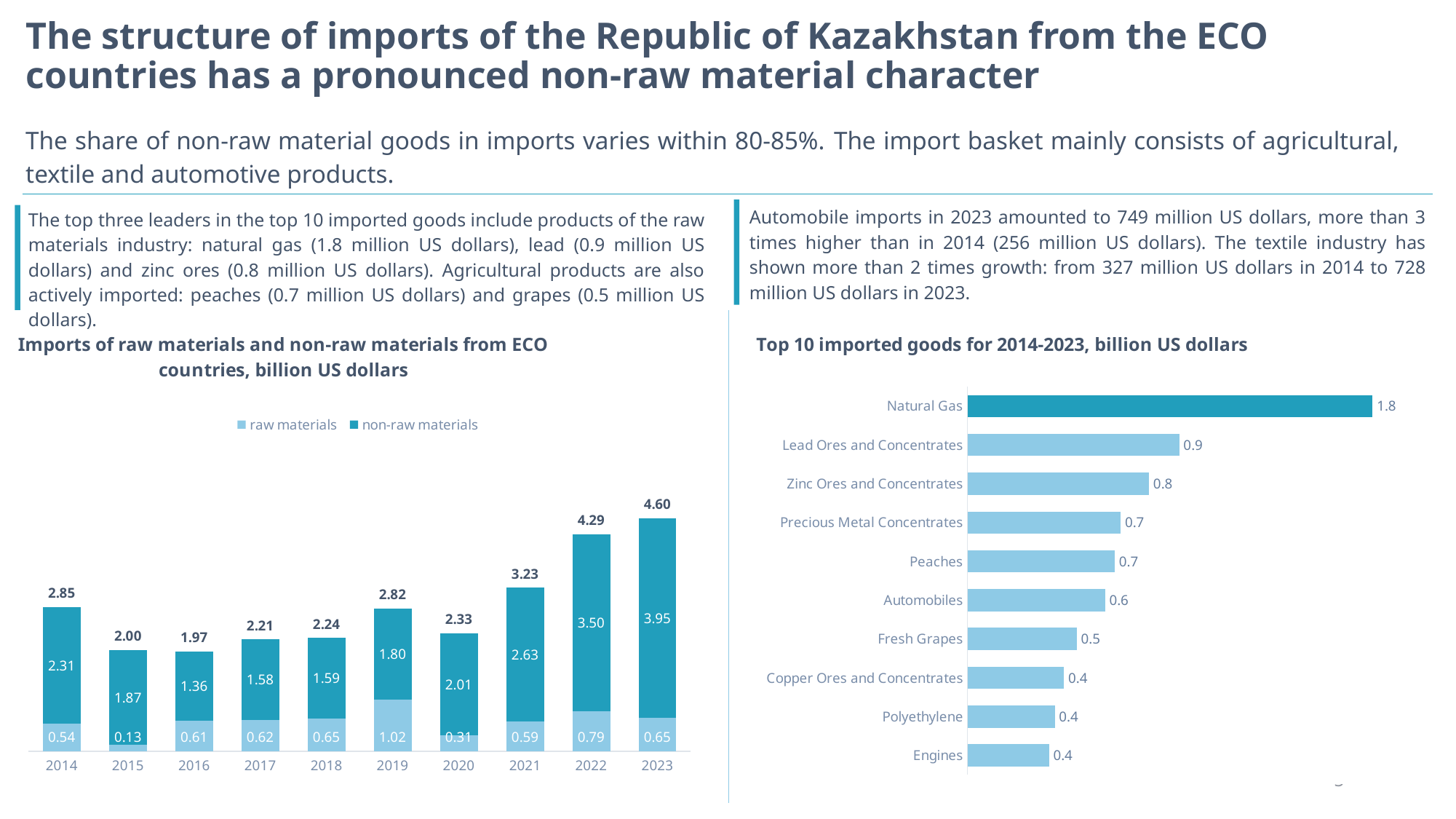
In the 'Imports of raw materials and non-raw materials from ECO countries' chart, how many years are shown on the x axis? 10 In the 'Imports of raw materials and non-raw materials from ECO countries' chart, what is the value for non-raw materials in 2021? 2.63 In the 'Top 10 imported goods for 2014-2023' chart, what is the value for Automobiles? 0.6 In the 'Imports of raw materials and non-raw materials from ECO countries' chart, what is the value for raw materials in 2019? 1.02 What kind of chart is the 'Top 10 imported goods for 2014-2023' chart? Bar chart In the 'Top 10 imported goods for 2014-2023' chart, which good has the highest value? Natural Gas In the 'Top 10 imported goods for 2014-2023' chart, what is the difference between Natural Gas and Lead Ores and Concentrates? 0.9 In the 'Imports of raw materials and non-raw materials from ECO countries' chart, what is the difference between the non-raw materials values for 2022 and 2014? 1.19 In the 'Imports of raw materials and non-raw materials from ECO countries' chart, what is the total of the stacked bar for 2023? 4.60 In the 'Imports of raw materials and non-raw materials from ECO countries' chart, how many series does the legend list? 2 In the 'Imports of raw materials and non-raw materials from ECO countries' chart, which year has the lowest raw materials value? 2015 In the 'Top 10 imported goods for 2014-2023' chart, which is larger, Zinc Ores and Concentrates or Fresh Grapes? Zinc Ores and Concentrates